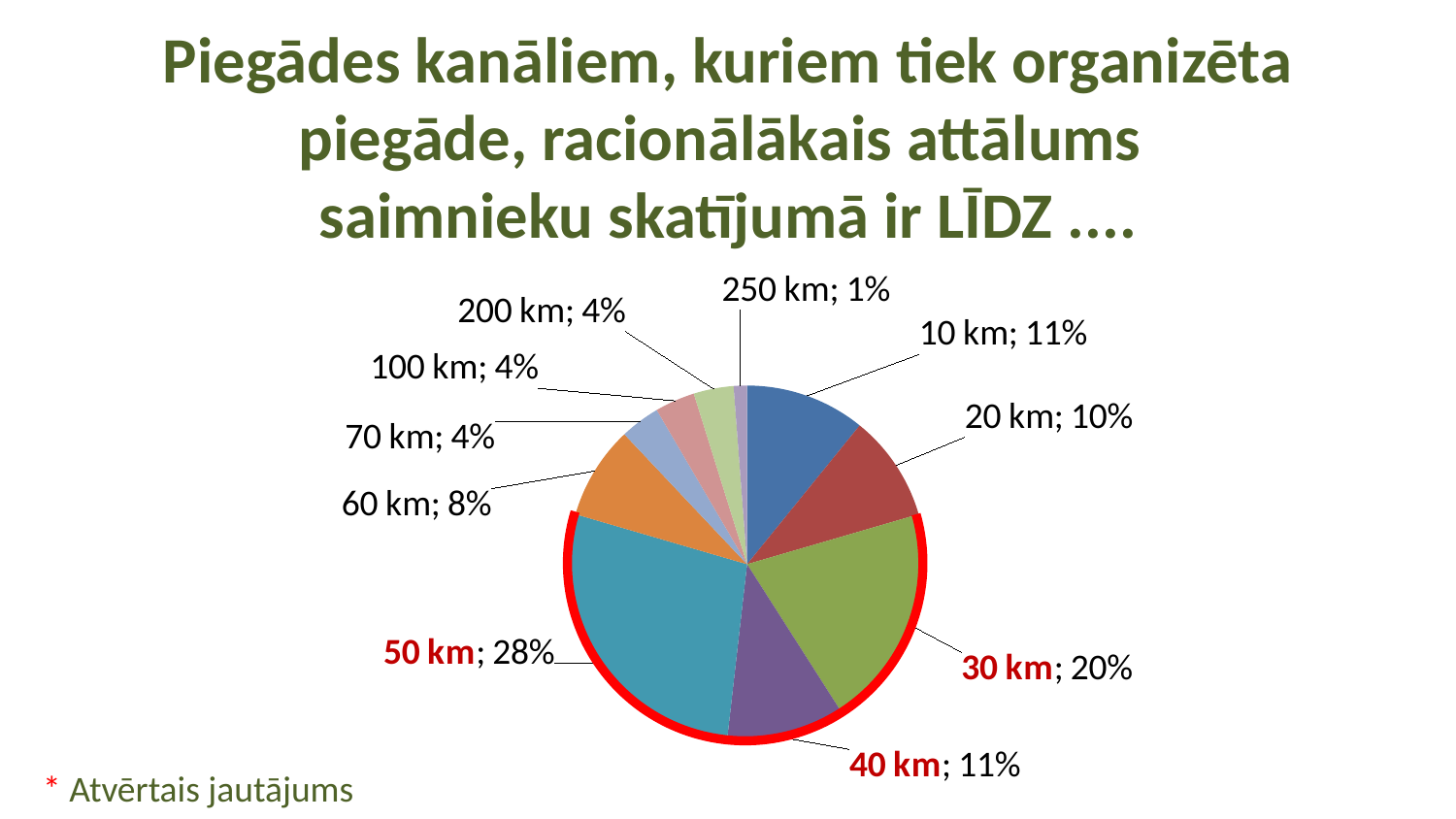
What percentage is shown for the 30 km slice? 20% What is the difference in percentage points between the 50 km slice and the 30 km slice? 8 What share of respondents chose 50 km as the most rational distance? 28% Which slice is larger, 10 km or 20 km? 10 km What percentage is shown for the 250 km slice? 1% Which three distance categories are highlighted with a red outline and red labels? 30 km, 40 km and 50 km What percentage is shown for the 60 km slice? 8% Which distance category has the largest share of the pie? 50 km How many distance categories are shown in the pie chart? 10 What kind of chart is shown on the slide? pie chart Which distance category has the smallest share of the pie? 250 km What is the combined share of the 30 km, 40 km and 50 km slices? 59%